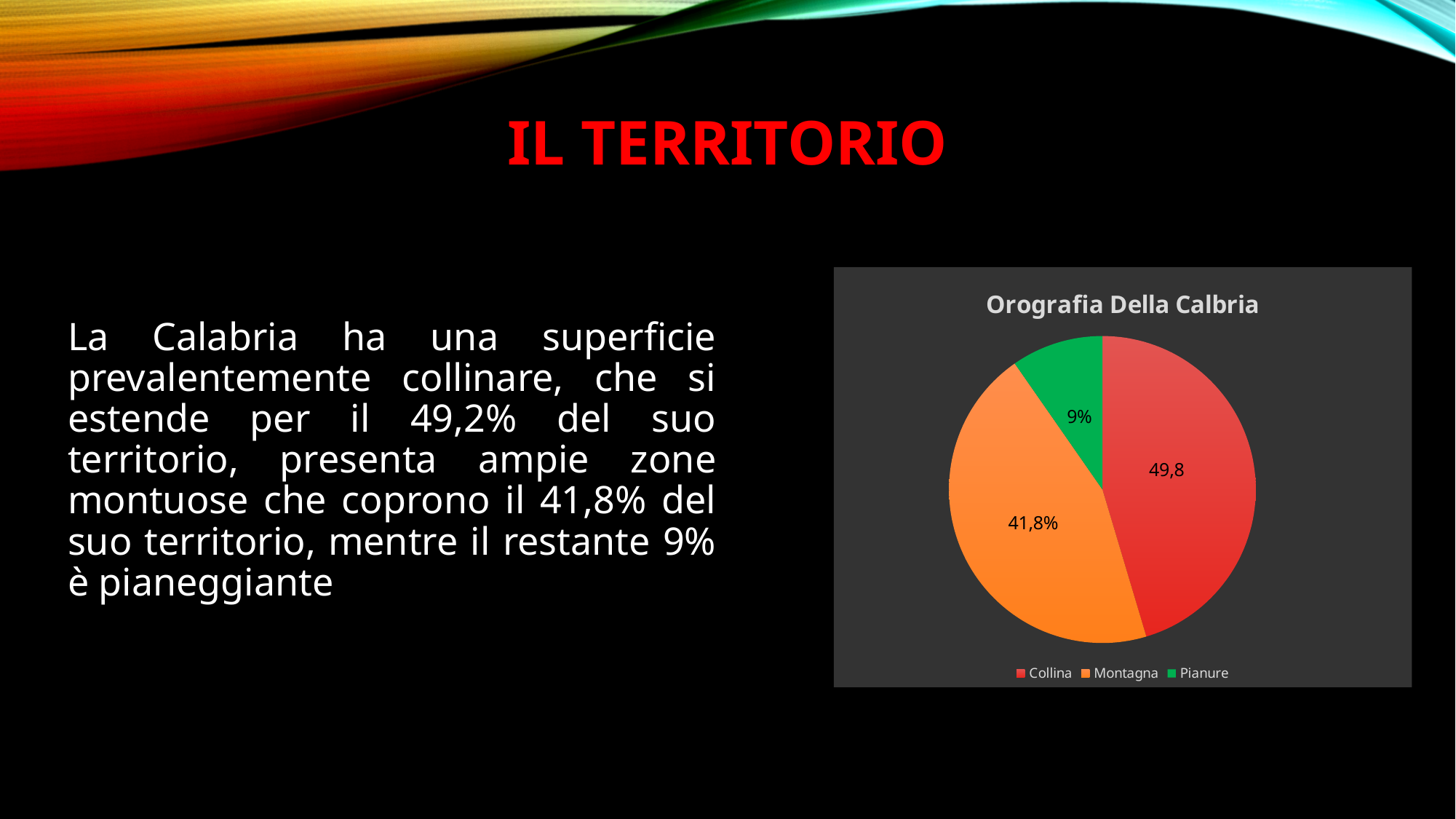
What value is labelled on the Pianure slice of the pie chart? 9% What value is labelled on the Collina slice of the pie chart? 49,8 Which category has the smallest slice of the pie chart? Pianure What kind of chart is shown on the slide? pie chart What is the difference between the Montagna slice and the Pianure slice? 32,8% How many entries does the legend of the pie chart list? 3 Which category has the largest slice of the pie chart? Collina What colour is the Pianure slice in the pie chart? green What value is labelled on the Montagna slice of the pie chart? 41,8% How many slices does the pie chart have? 3 What is the title of the chart? Orografia Della Calbria Which slice is larger, Montagna or Pianure? Montagna